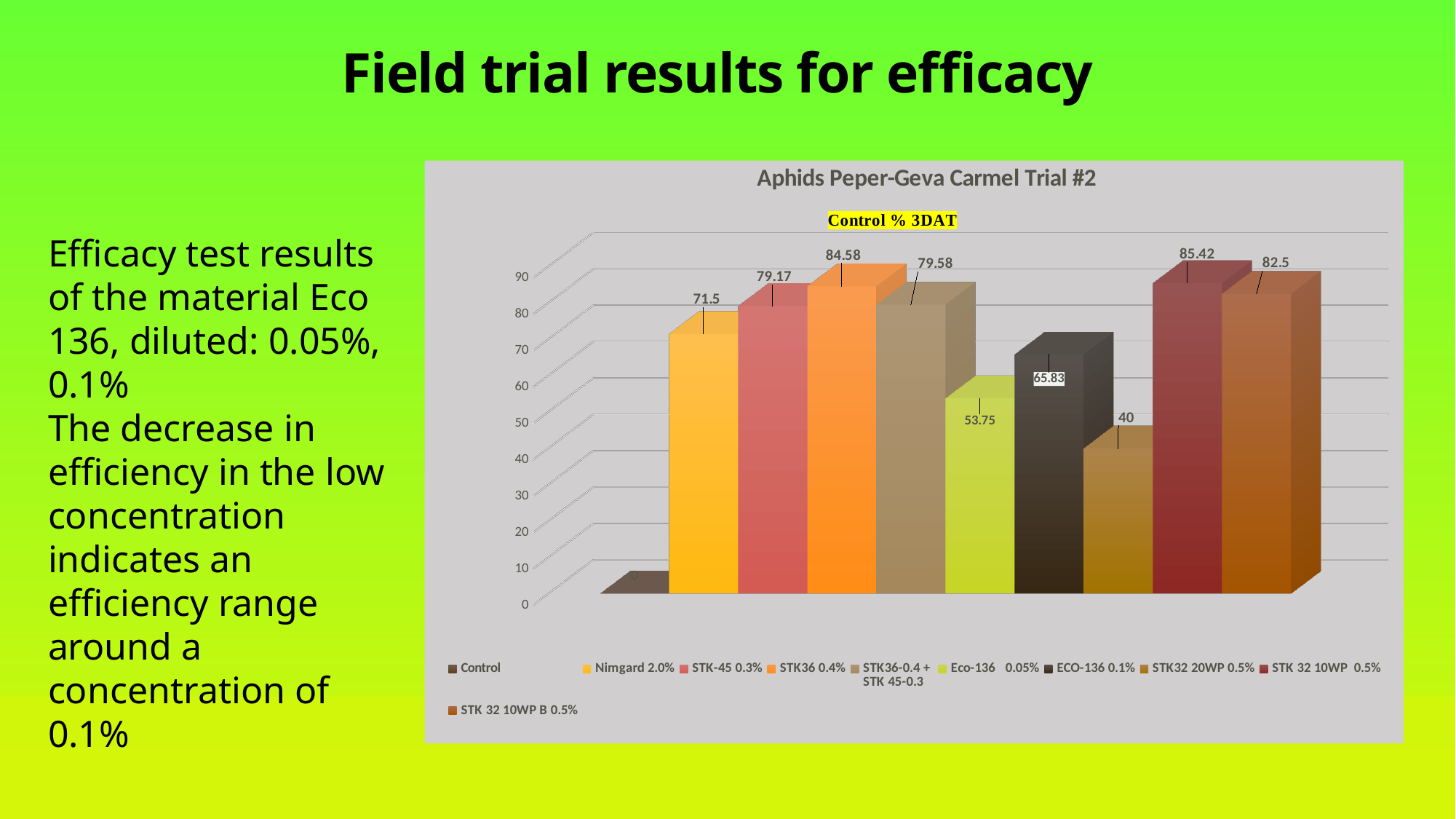
What is the value for Nimgard 2.0% in the Aphids Peper-Geva Carmel Trial #2 chart? 71.5 What is the title of the chart? Aphids Peper-Geva Carmel Trial #2 What is the value for Eco-136 0.05% in the chart? 53.75 Which treatment has the highest value in the chart? STK 32 10WP 0.5% What is the difference between the values for ECO-136 0.1% and Eco-136 0.05%? 12.08 Is the value for STK-45 0.3% greater or less than 70? greater What is the value for STK32 20WP 0.5% in the chart? 40 How many series does the legend list? 10 What is the value for ECO-136 0.1% in the chart? 65.83 Which is larger, the value for STK36 0.4% or the value for STK 32 10WP B 0.5%? STK36 0.4% Excluding Control, which treatment has the lowest value in the chart? STK32 20WP 0.5% What kind of chart is shown on the slide? Bar chart